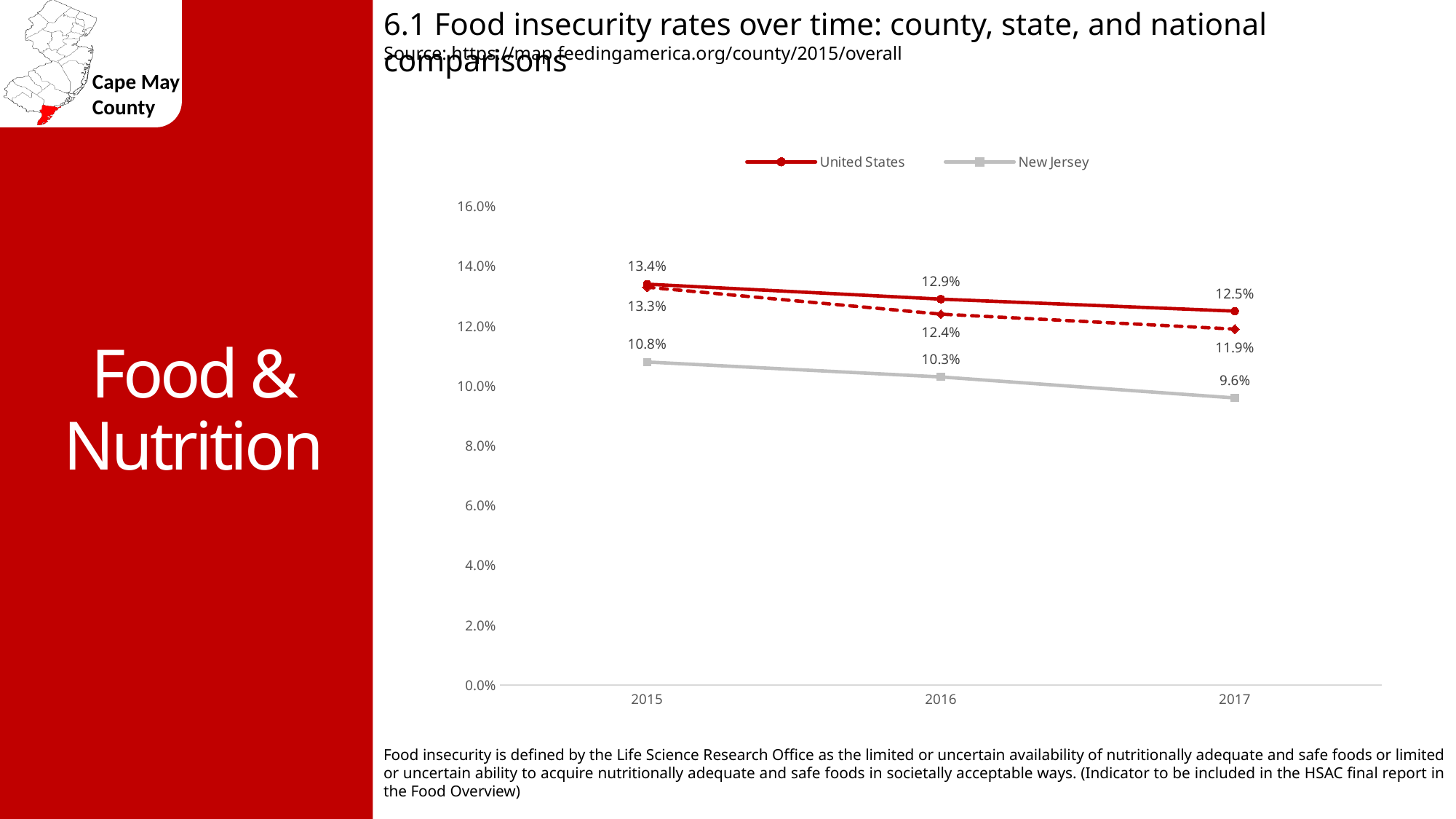
What is the food insecurity rate for New Jersey in 2017? 9.6% By how much did the United States food insecurity rate fall from 2015 to 2017? 0.9% Does the New Jersey food insecurity rate rise or fall from 2015 to 2017? fall How many series does the chart legend list? 2 Which has the higher food insecurity rate in 2017, the United States or New Jersey? United States What is the food insecurity rate for the United States in 2017? 12.5% What is the food insecurity rate for the United States in 2015? 13.4% What is the food insecurity rate for New Jersey in 2016? 10.3% What is the difference between the United States and New Jersey food insecurity rates in 2016? 2.6% How many years are shown on the x axis of the chart? 3 In which year is the United States food insecurity rate lowest? 2017 In which year is the New Jersey food insecurity rate highest? 2015